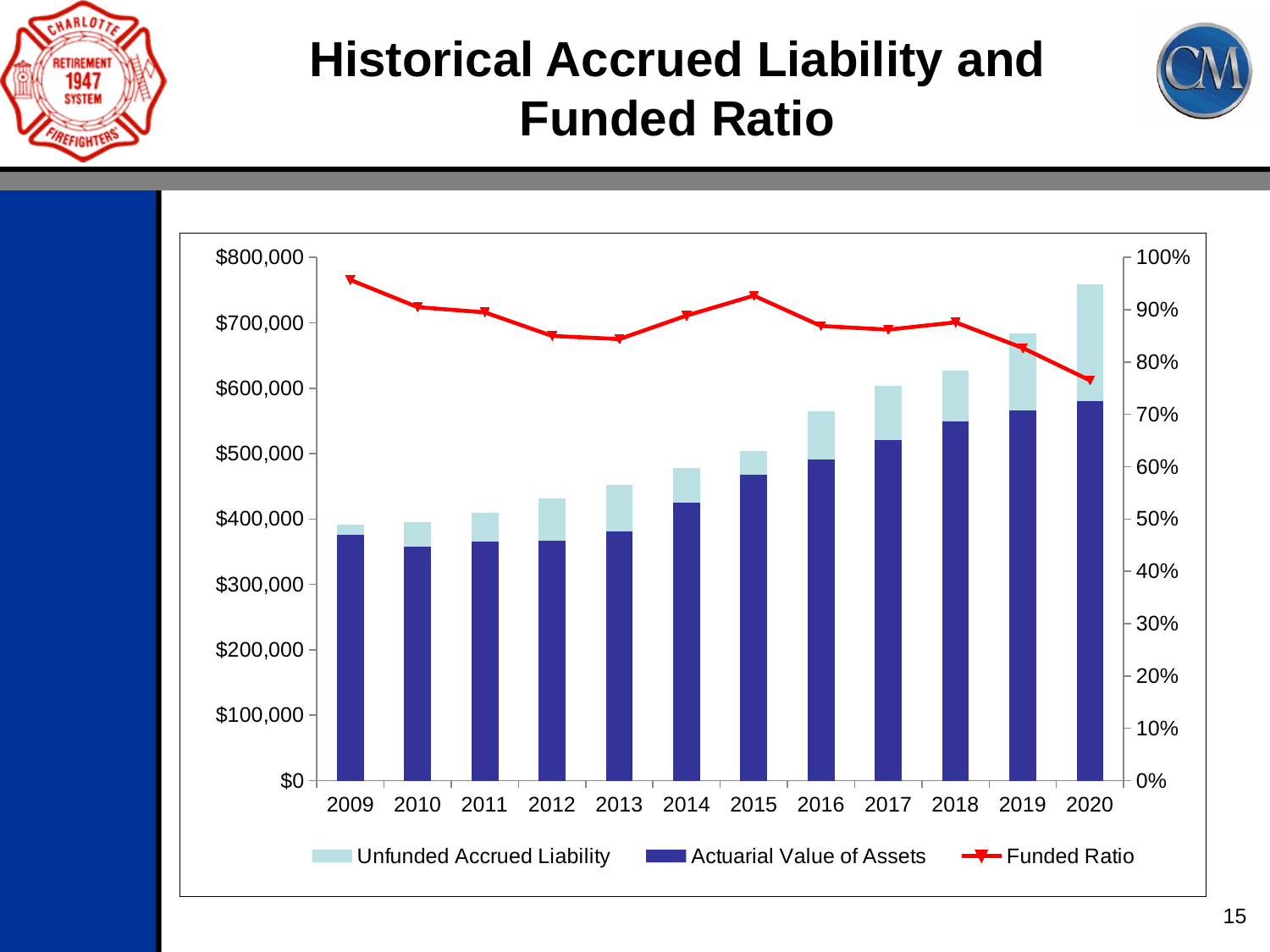
Does the Actuarial Value of Assets rise or fall from 2013 to 2020? rise What kind of chart is shown on the slide? A combination bar and line chart Is the Funded Ratio for 2020 greater or less than 80%? less Which year has the larger total accrued liability (full stacked bar), 2019 or 2020? 2020 How many years are shown on the x axis? 12 Is the Funded Ratio for 2009 greater or less than 90%? greater How many series does the legend list? 3 Is the Actuarial Value of Assets for 2020 greater or less than $500,000? greater In which year is the Actuarial Value of Assets highest? 2020 In which year is the Funded Ratio lowest? 2020 In which year is the Funded Ratio highest? 2009